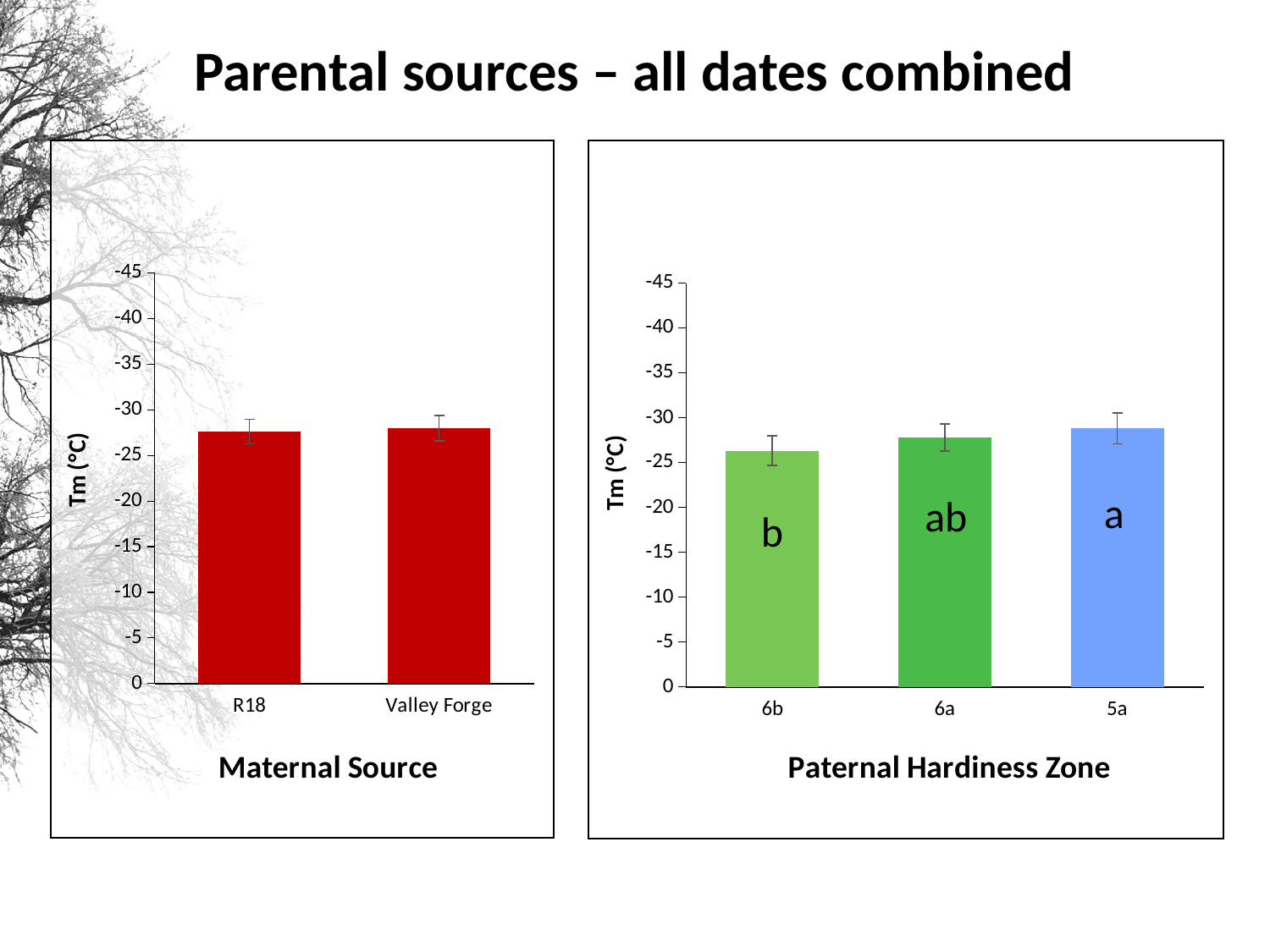
How many categories are shown on the Maternal Source chart on the left? 2 What are the two category labels on the x axis of the Maternal Source chart? R18 and Valley Forge On the Paternal Hardiness Zone chart, is the bar for 5a taller or shorter than the bar for 6b? taller On the Paternal Hardiness Zone chart, is the value for 6b greater or less than -30? greater On the Paternal Hardiness Zone chart, do the bars get taller or shorter moving from 6b to 5a along the x axis? taller On the Paternal Hardiness Zone chart, which category has the shortest bar (the least negative Tm)? 6b How many categories are shown on the Paternal Hardiness Zone chart on the right? 3 On the Paternal Hardiness Zone chart, which category has the tallest bar (the most negative Tm)? 5a On the Paternal Hardiness Zone chart, is the value for 5a greater or less than -25? less What kind of chart is the Maternal Source chart on the left? bar chart What is the y-axis label on the Maternal Source chart? Tm (°C) What letter is printed on the 6a bar of the Paternal Hardiness Zone chart? ab